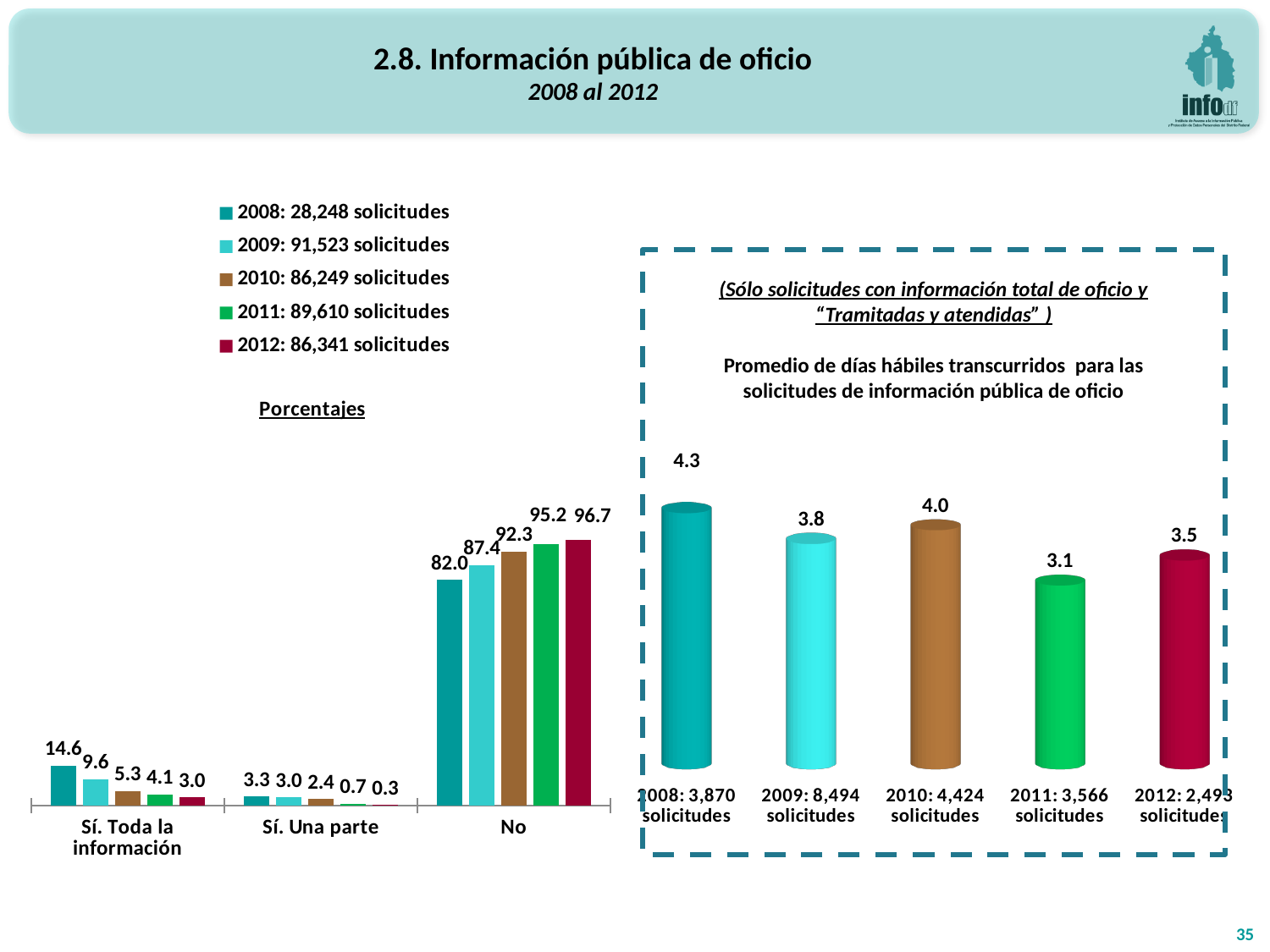
In the left 'Porcentajes' chart, what is the value for 2012 in the 'Sí. Toda la información' category? 3.0 In the left 'Porcentajes' chart, do the values in the 'No' category rise or fall from 2008 to 2012? rise In the right chart on average business days, what is the value for 2010? 4.0 In the left 'Porcentajes' chart, which year has the lowest value in the 'Sí. Toda la información' category? 2012 In the left 'Porcentajes' chart, which year has the highest value in the 'No' category? 2012 In the left 'Porcentajes' chart, what is the difference between the 2012 and 2008 values in the 'No' category? 14.7 In the left 'Porcentajes' chart, what is the value for 2011 in the 'Sí. Una parte' category? 0.7 In the right chart on average business days, which is larger, the value for 2009 or the value for 2012? 2009 What kind of chart is the right chart on average business days? bar chart In the right chart on average business days, which year has the lowest value? 2011 In the left 'Porcentajes' chart, how many series does the legend list? 5 In the left 'Porcentajes' chart, what is the value for 2008 in the 'No' category? 82.0